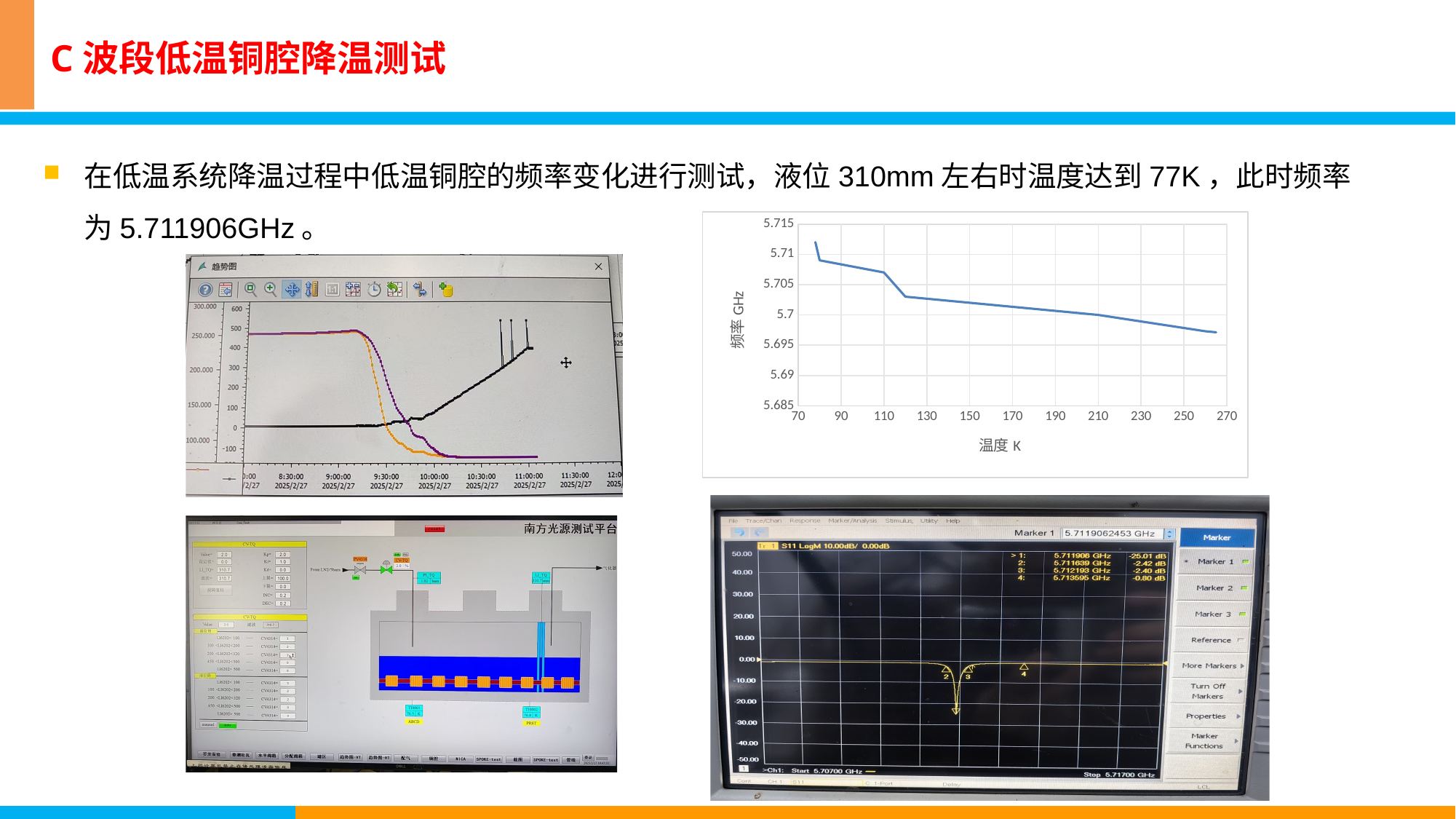
In the top-right chart, is the frequency at the lowest plotted temperature (about 78 K) greater or less than 5.71 GHz? greater In the top-right chart, is the frequency at about 110 K greater or less than 5.705 GHz? greater In the top-right chart, which end of the temperature range has the higher frequency: the low-temperature end near 80 K or the high-temperature end near 265 K? the low-temperature end near 80 K On the network analyzer screen photo at the bottom right, what frequency is shown for Marker 1? 5.711906 GHz In the top-right chart, is the frequency at about 130 K greater or less than 5.705 GHz? less In the top-right chart, what is the highest tick value shown on the y axis? 5.715 In the top-right chart, what is the label of the x axis? 温度 K On the network analyzer screen photo at the bottom right, what S11 value in dB is shown for marker 1? -25.01 dB What kind of chart is the chart of 频率 GHz against 温度 K at the top right of the slide? line chart In the top-right chart of 频率 GHz against 温度 K, does the frequency rise or fall as temperature increases along the x axis? fall In the top-right chart, what is the label of the y axis? 频率 GHz